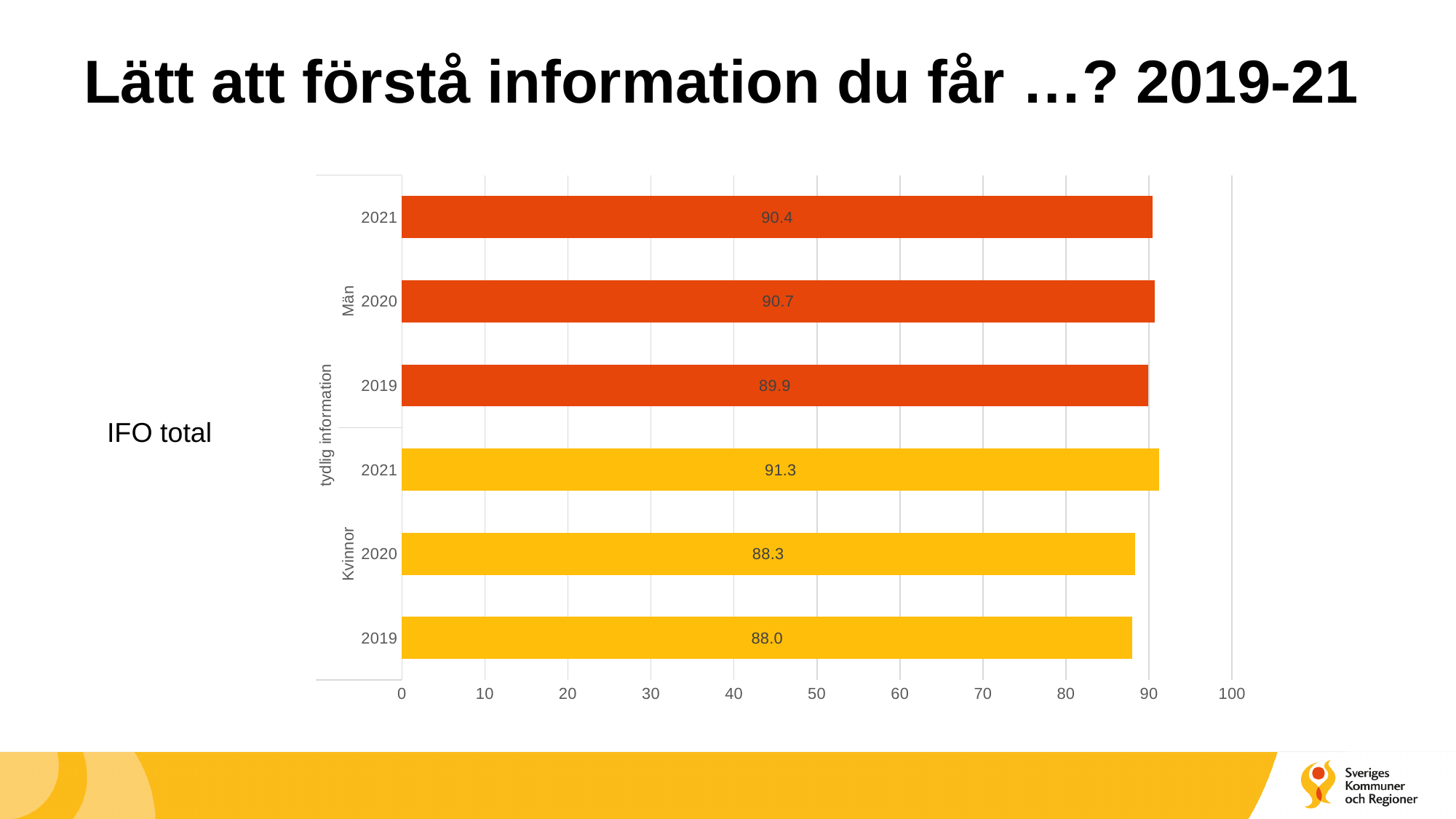
Which bar has the highest value? Kvinnor 2021 Which bar has the lowest value? Kvinnor 2019 What kind of chart is shown on the slide? Bar chart Which is larger, the Kvinnor 2021 value or the Män 2021 value? Kvinnor 2021 What is the value for Kvinnor in 2019? 88.0 What is the value for Kvinnor in 2020? 88.3 What is the value for Män in 2019? 89.9 What is the difference between the Kvinnor 2021 value and the Kvinnor 2019 value? 3.3 How many bars are shown in the chart? 6 What is the label on the vertical axis of the chart? tydlig information What is the value for Män in 2021? 90.4 What is the difference between the Män 2020 value and the Män 2021 value? 0.3